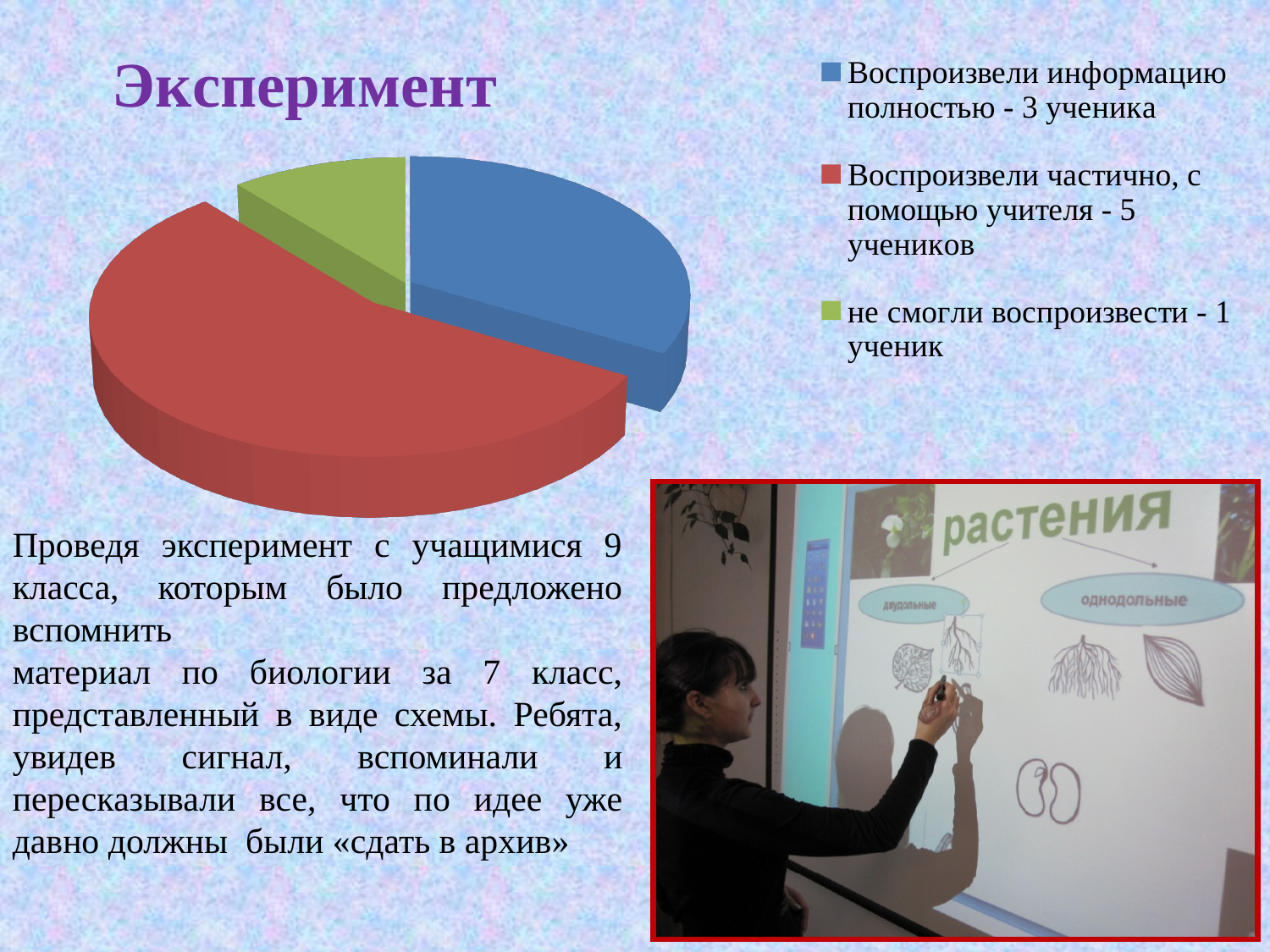
Which is larger: the number of students who reproduced fully or the number who could not reproduce? Воспроизвели информацию полностью What kind of chart is shown on the slide? pie chart Which colour represents the category 'не смогли воспроизвести' in the pie chart? green How many slices does the pie chart have? 3 How many students reproduced the information partially with the teacher's help (Воспроизвели частично, с помощью учителя)? 5 учеников What is the title of the slide with the pie chart? Эксперимент Which category has the largest slice of the pie chart? Воспроизвели частично, с помощью учителя Which category has the smallest slice of the pie chart? не смогли воспроизвести How many students could not reproduce the information (не смогли воспроизвести)? 1 ученик What is the difference between the number of students who reproduced partially and those who reproduced fully? 2 How many students reproduced the information fully (Воспроизвели информацию полностью)? 3 ученика How many entries does the legend of the pie chart list? 3